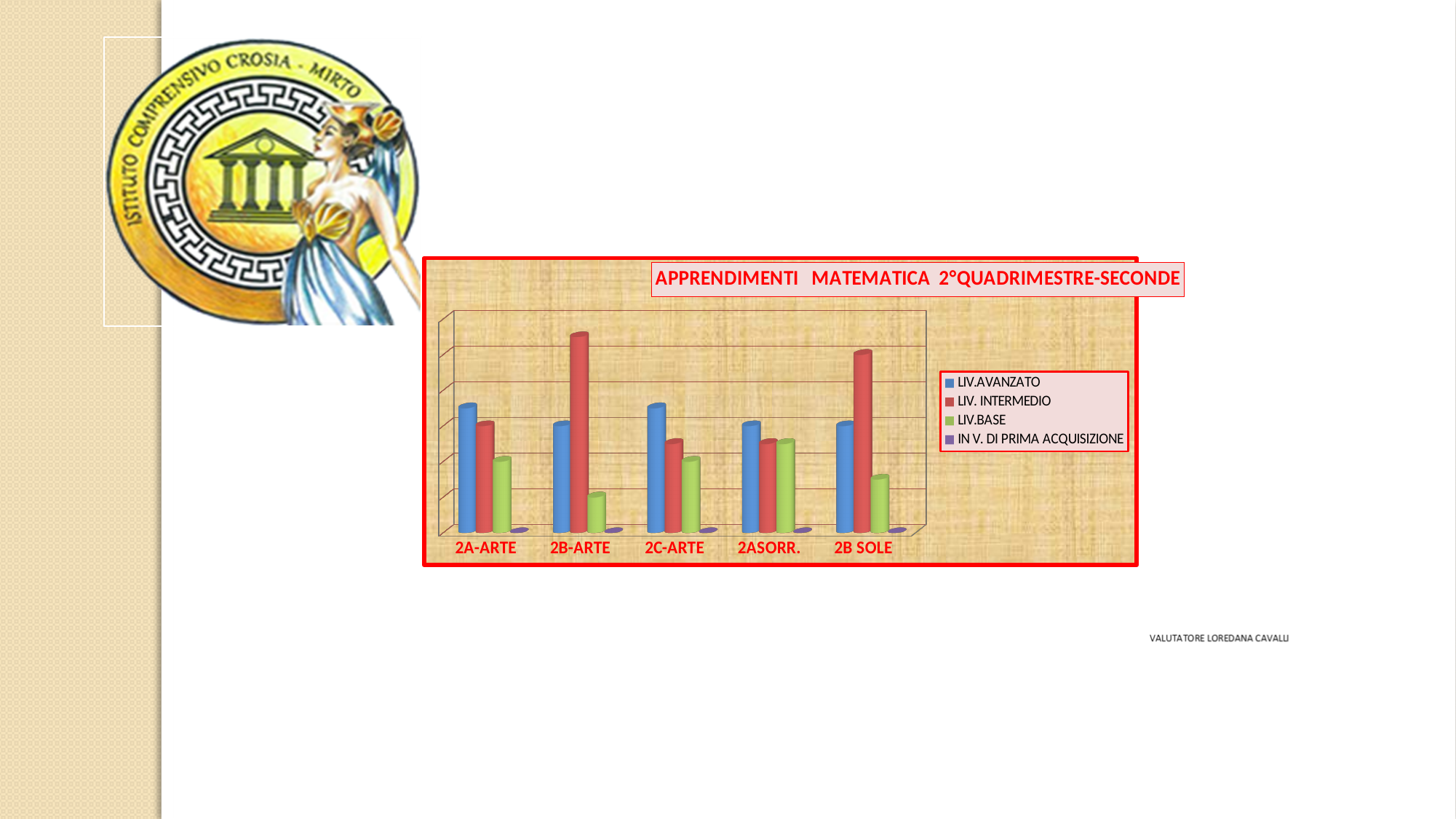
For 2B SOLE, which is larger: LIV. INTERMEDIO or LIV.BASE? LIV. INTERMEDIO Which series has the lowest values across all classes in the chart? IN V. DI PRIMA ACQUISIZIONE For 2B-ARTE, which is larger: LIV.AVANZATO or LIV. INTERMEDIO? LIV. INTERMEDIO For 2C-ARTE, which is larger: LIV.AVANZATO or LIV.BASE? LIV.AVANZATO What is the title of the chart? APPRENDIMENTI MATEMATICA 2°QUADRIMESTRE-SECONDE How many series does the chart's legend list? 4 Which series is shown in green in the chart? LIV.BASE Which class has the lowest LIV.BASE bar? 2B-ARTE How many classes (categories) are shown on the x axis of the chart? 5 Which class has the highest LIV. INTERMEDIO bar? 2B-ARTE What kind of chart is shown on the slide? bar chart